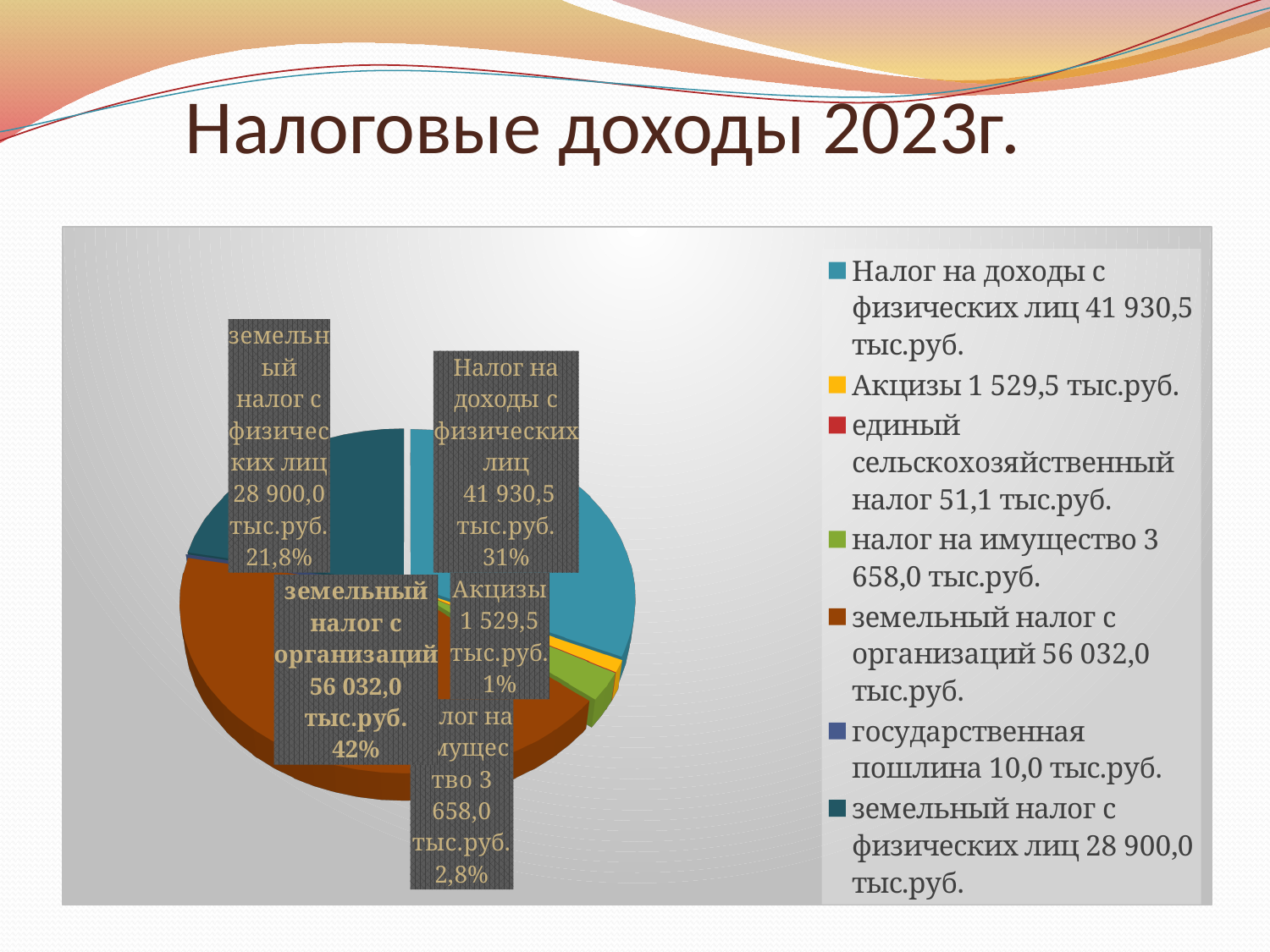
Which category has the smallest value in the pie chart? государственная пошлина What kind of chart is shown on the slide? pie chart What share of the pie does земельный налог с физических лиц represent? 21,8% What share of the pie does земельный налог с организаций represent? 42% What is the value for Налог на доходы с физических лиц? 41 930,5 тыс.руб. What is the value for земельный налог с организаций? 56 032,0 тыс.руб. What is the value for единый сельскохозяйственный налог? 51,1 тыс.руб. What is the title of the slide containing the pie chart? Налоговые доходы 2023г. Which is larger: Акцизы or налог на имущество? налог на имущество What is the difference between the values for земельный налог с организаций and Налог на доходы с физических лиц? 14 101,5 тыс.руб. Which category has the largest value in the pie chart? земельный налог с организаций How many categories does the legend of the pie chart list? 7